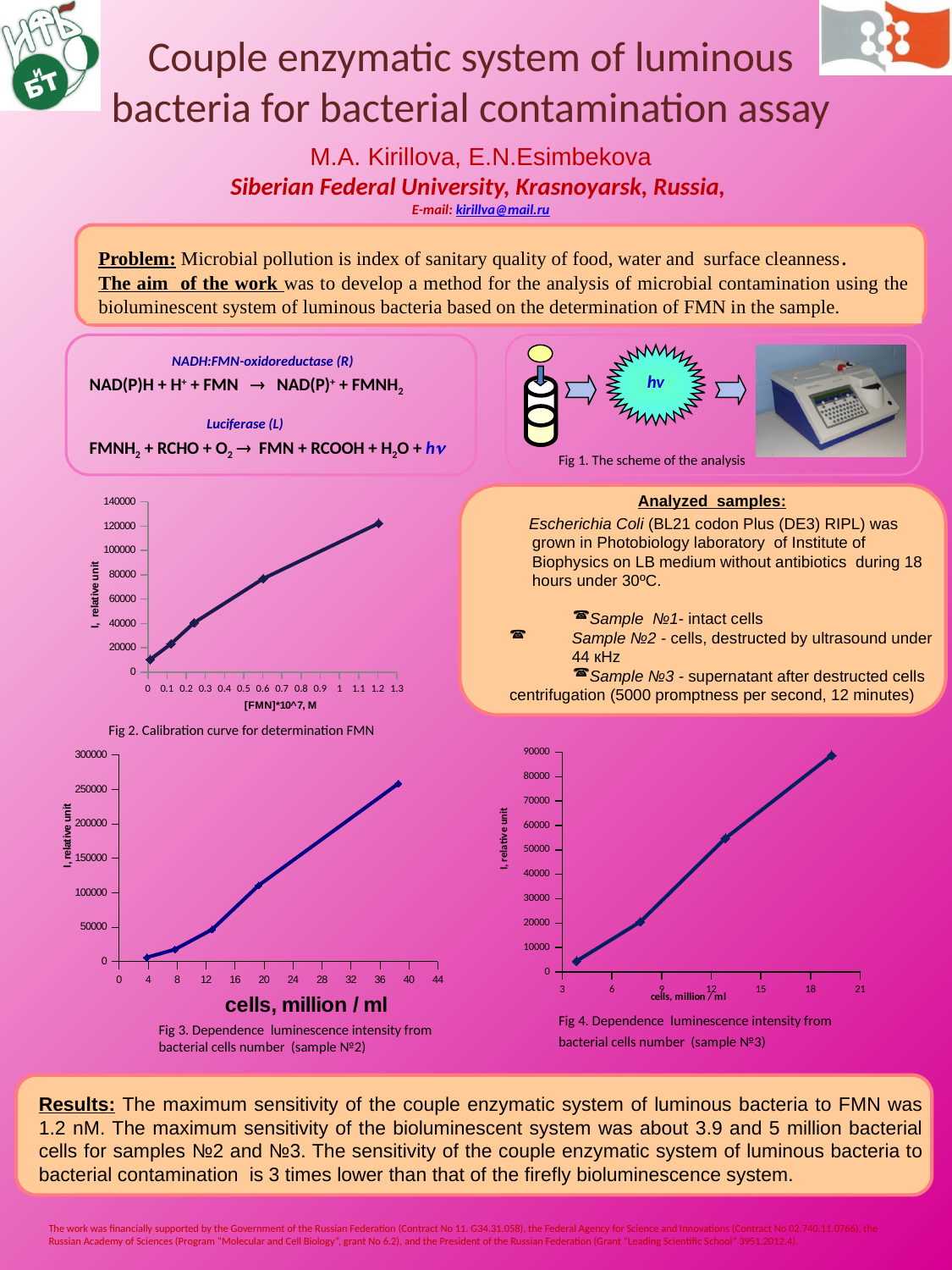
How many data points are plotted in Fig 4 (sample №3)? 4 How many data points are plotted in Fig 2, the calibration curve for determination FMN? 5 How many data points are plotted in Fig 3 (sample №2)? 5 What kind of chart is Fig 2, the calibration curve for determination FMN? line chart In Fig 3 (sample №2), do the luminescence intensity values rise or fall as the cell number increases? rise In Fig 3 (sample №2), is the value at the highest cell concentration plotted greater or less than 200000? greater What is the x-axis title of Fig 2, the calibration curve for determination FMN? [FMN]*10^7, M What is the y-axis title of Fig 4 (sample №3)? I, relative unit In Fig 4 (sample №3), is the value at the highest cell concentration plotted greater or less than 80000? greater In Fig 2 (calibration curve for determination FMN), is the value at [FMN]*10^7 = 1.2 greater or less than 100000? greater In Fig 2 (calibration curve for determination FMN), do the values rise or fall as [FMN] increases along the x axis? rise